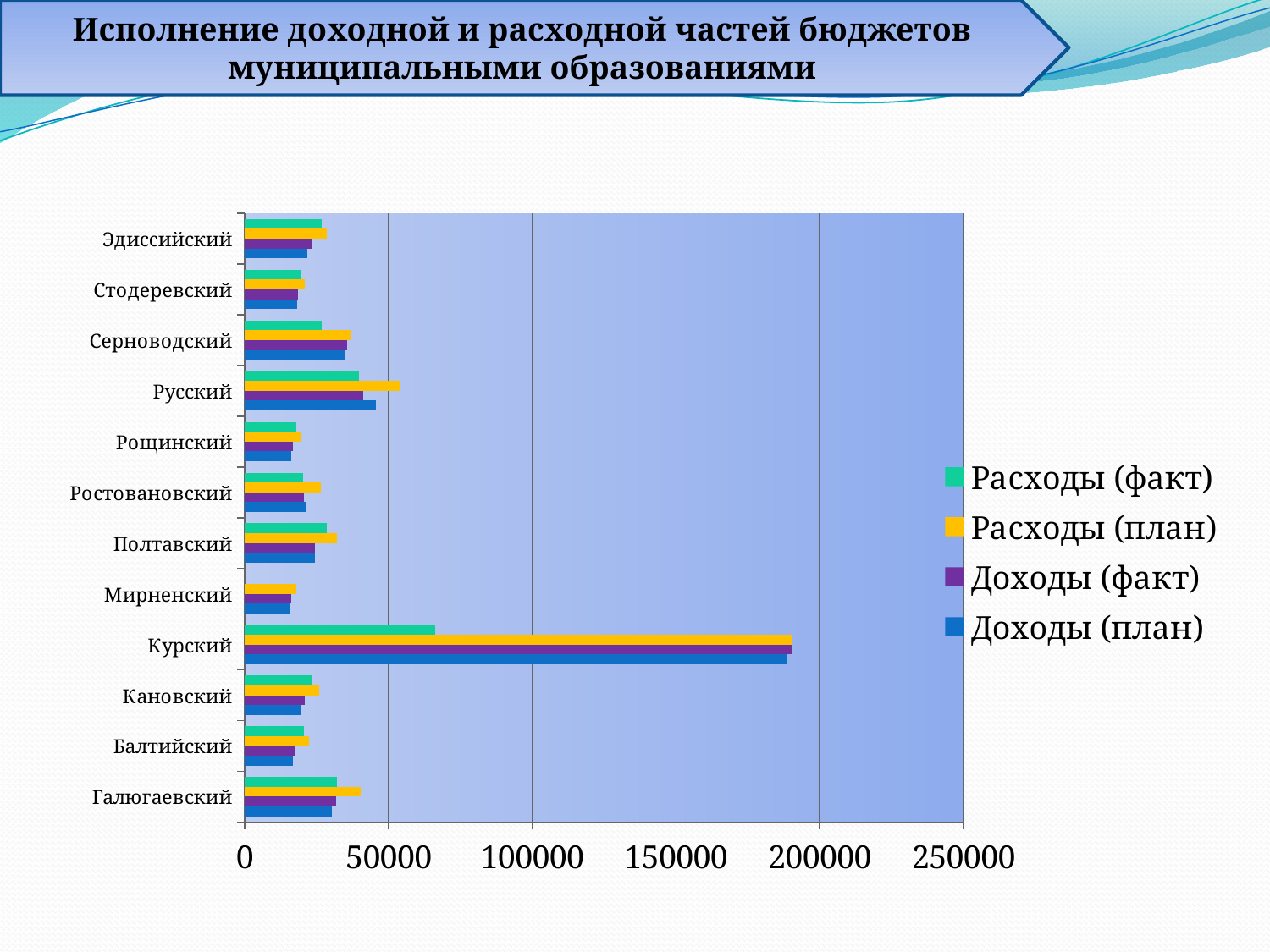
Is the value of Расходы (факт) for Курский greater or less than 50000? greater For Курский, which is larger: Расходы (план) or Расходы (факт)? Расходы (план) Is the value of Доходы (план) for Курский greater or less than 150000? greater What kind of chart is shown on the slide? bar chart How many municipalities (categories) are listed on the vertical axis of the chart? 12 Which municipality has the highest value for Расходы (факт)? Курский Is the value of Расходы (план) for Курский greater or less than 200000? less How many series does the chart legend list? 4 What is the title of the slide? Исполнение доходной и расходной частей бюджетов муниципальными образованиями Which municipality has the highest value for Доходы (план)? Курский Which has the larger Расходы (план) value: Галюгаевский or Балтийский? Галюгаевский